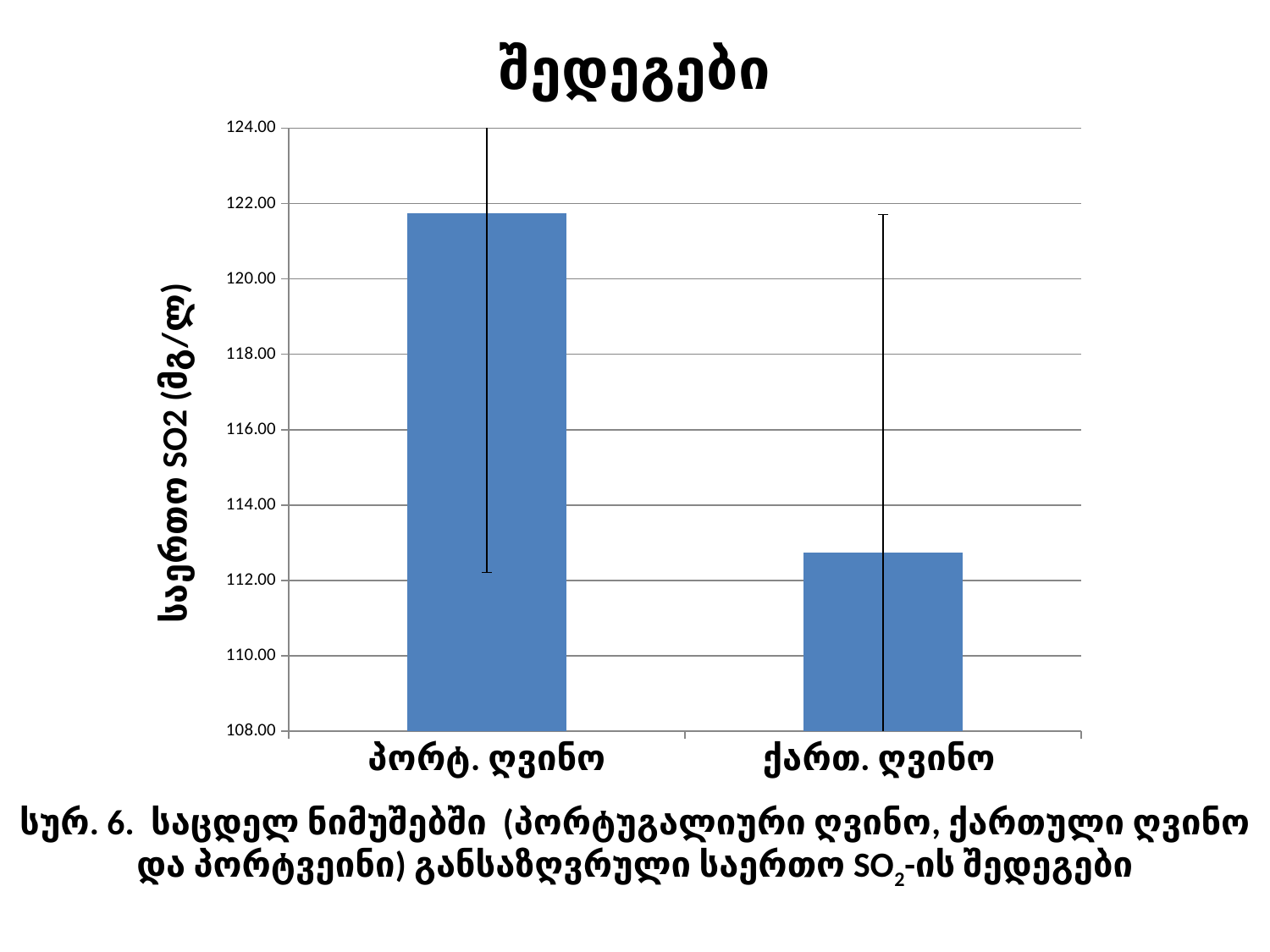
What is the label of the vertical axis of the chart? საერთო SO2 (მგ/ლ) Do the bar values rise or fall from left to right along the x axis? fall Is the value for ქართ. ღვინო greater or less than 112.00? greater Is the value for ქართ. ღვინო greater or less than 114.00? less How many categories are plotted on the x axis of the chart? 2 Is the value for პორტ. ღვინო greater or less than 120.00? greater Which category has the highest bar in the chart? პორტ. ღვინო What is the title of the chart? შედეგები Which category has the lowest bar in the chart? ქართ. ღვინო What kind of chart is shown on the slide? bar chart Which bar is taller, პორტ. ღვინო or ქართ. ღვინო? პორტ. ღვინო